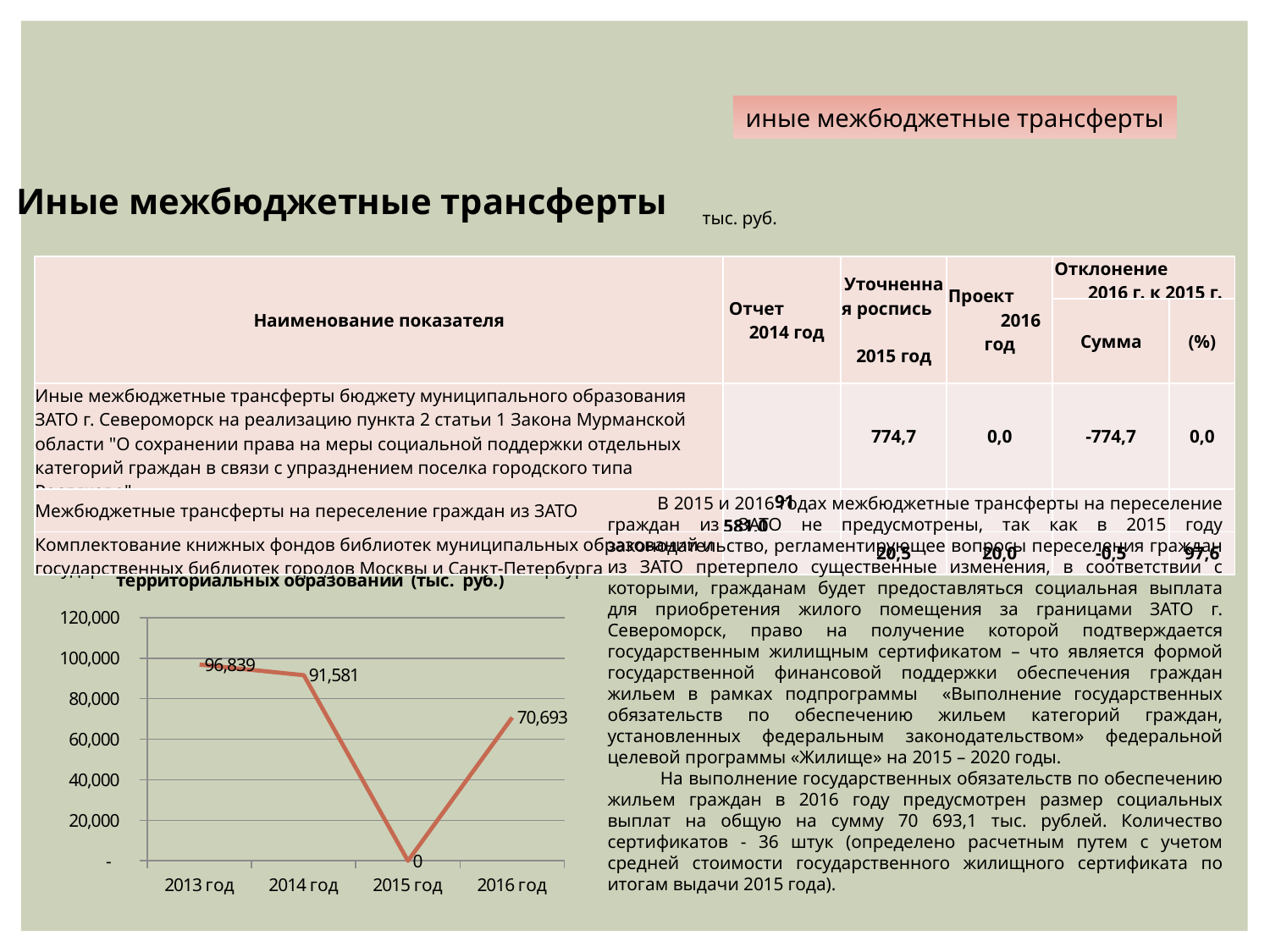
Which is larger on the line chart, the value for 2014 год or the value for 2016 год? 2014 год What kind of chart is shown on the slide? line chart What is the value plotted for 2015 год on the line chart? 0 What is the difference between the values for 2014 год and 2016 год on the line chart? 20,888 What is the difference between the values for 2013 год and 2014 год on the line chart? 5,258 How many years are plotted on the line chart? 4 What is the value plotted for 2013 год on the line chart? 96,839 Is the value for 2016 год on the line chart greater or less than 80,000? less What is the value plotted for 2014 год on the line chart? 91,581 Which year has the highest value on the line chart? 2013 год Which year has the lowest value on the line chart? 2015 год What is the value plotted for 2016 год on the line chart? 70,693